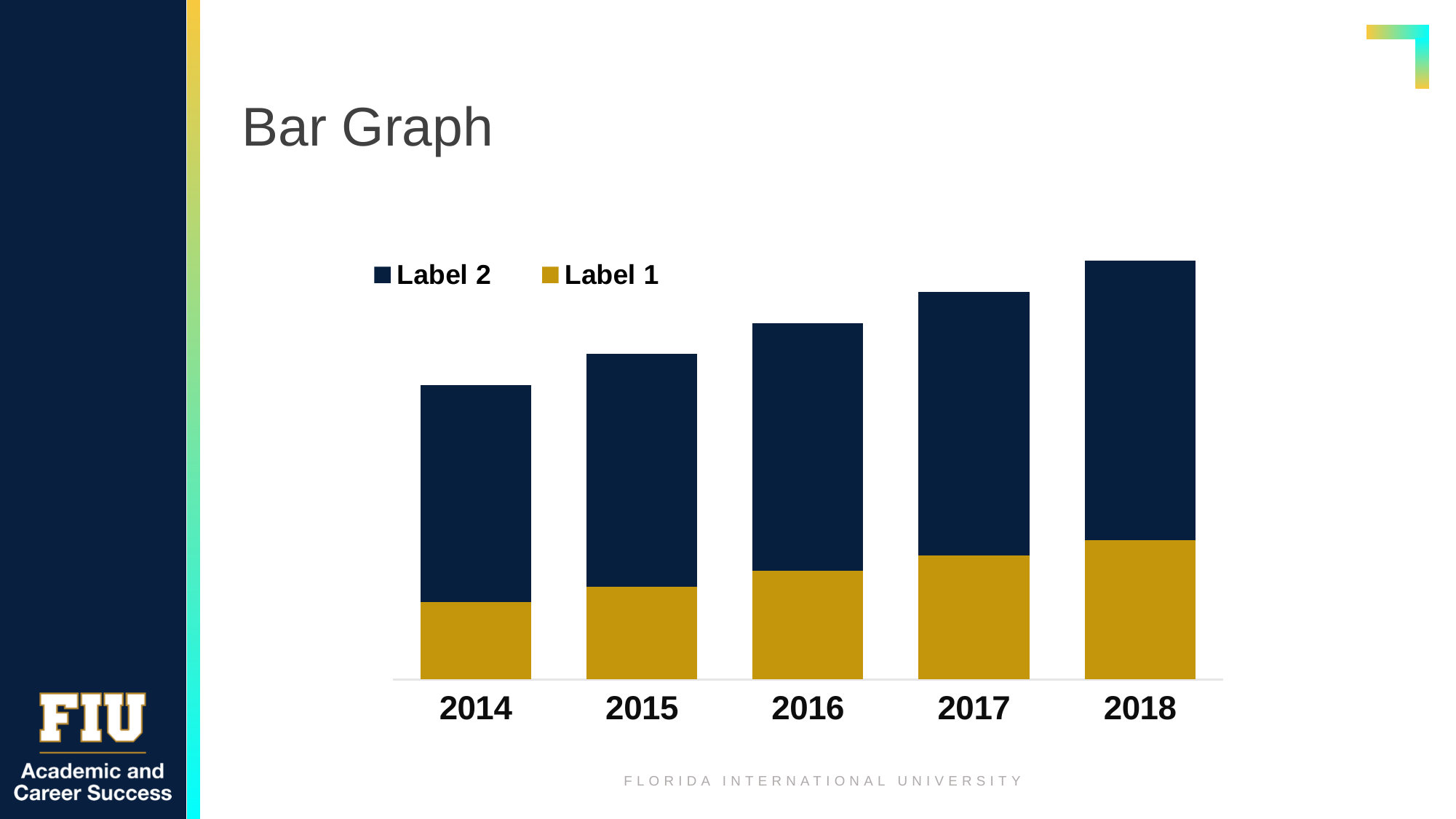
What is the title of the slide containing the chart? Bar Graph How many series does the chart's legend list? 2 Which series is shown in gold in the chart? Label 1 Which year has the larger Label 1 segment, 2014 or 2016? 2016 Which has the taller total bar, 2015 or 2017? 2017 Do the total bar heights rise or fall from 2014 to 2018? Rise Which year has the smallest Label 1 segment? 2014 What kind of chart is shown on the slide? Stacked bar chart How many years are shown along the x axis of the chart? 5 Which year has the tallest stacked bar overall? 2018 Which year has the shortest stacked bar overall? 2014 Which year has the largest Label 1 segment? 2018